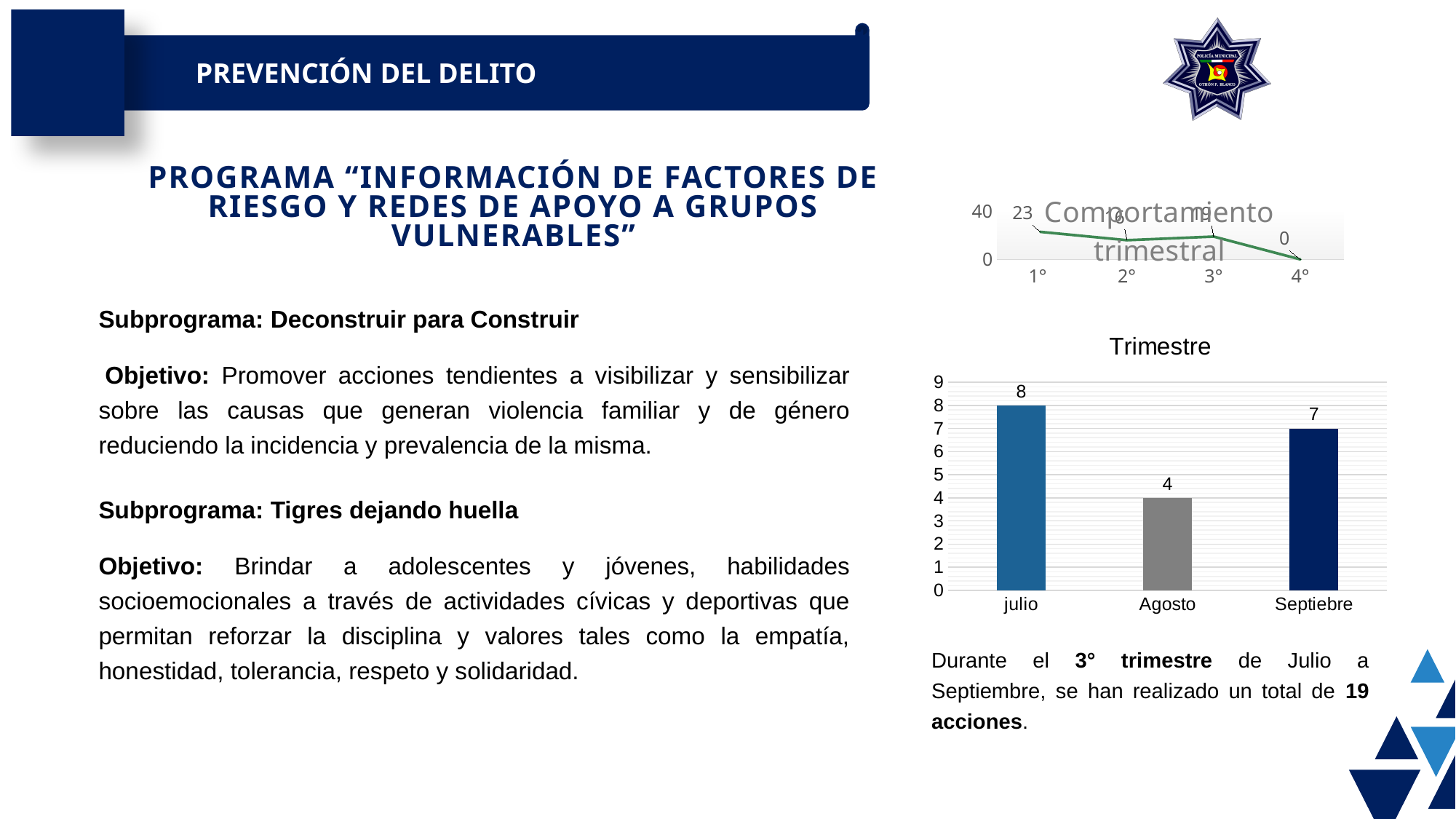
What kind of chart is the 'Trimestre' chart? bar chart In the 'Trimestre' bar chart, which is larger, the value for Septiebre or the value for Agosto? Septiebre In the 'Trimestre' bar chart, what is the value for Agosto? 4 In the 'Trimestre' bar chart, which month has the lowest value? Agosto In the 'Comportamiento trimestral' line chart, what is the value for 1°? 23 In the 'Comportamiento trimestral' line chart, what is the value for 4°? 0 In the 'Trimestre' bar chart, what is the value for Septiebre? 7 In the 'Trimestre' bar chart, which month has the highest value? julio How many bars are shown in the 'Trimestre' bar chart? 3 What kind of chart is the 'Comportamiento trimestral' chart? line chart In the 'Trimestre' bar chart, what is the difference between the values for julio and Agosto? 4 In the 'Trimestre' bar chart, what is the value for julio? 8